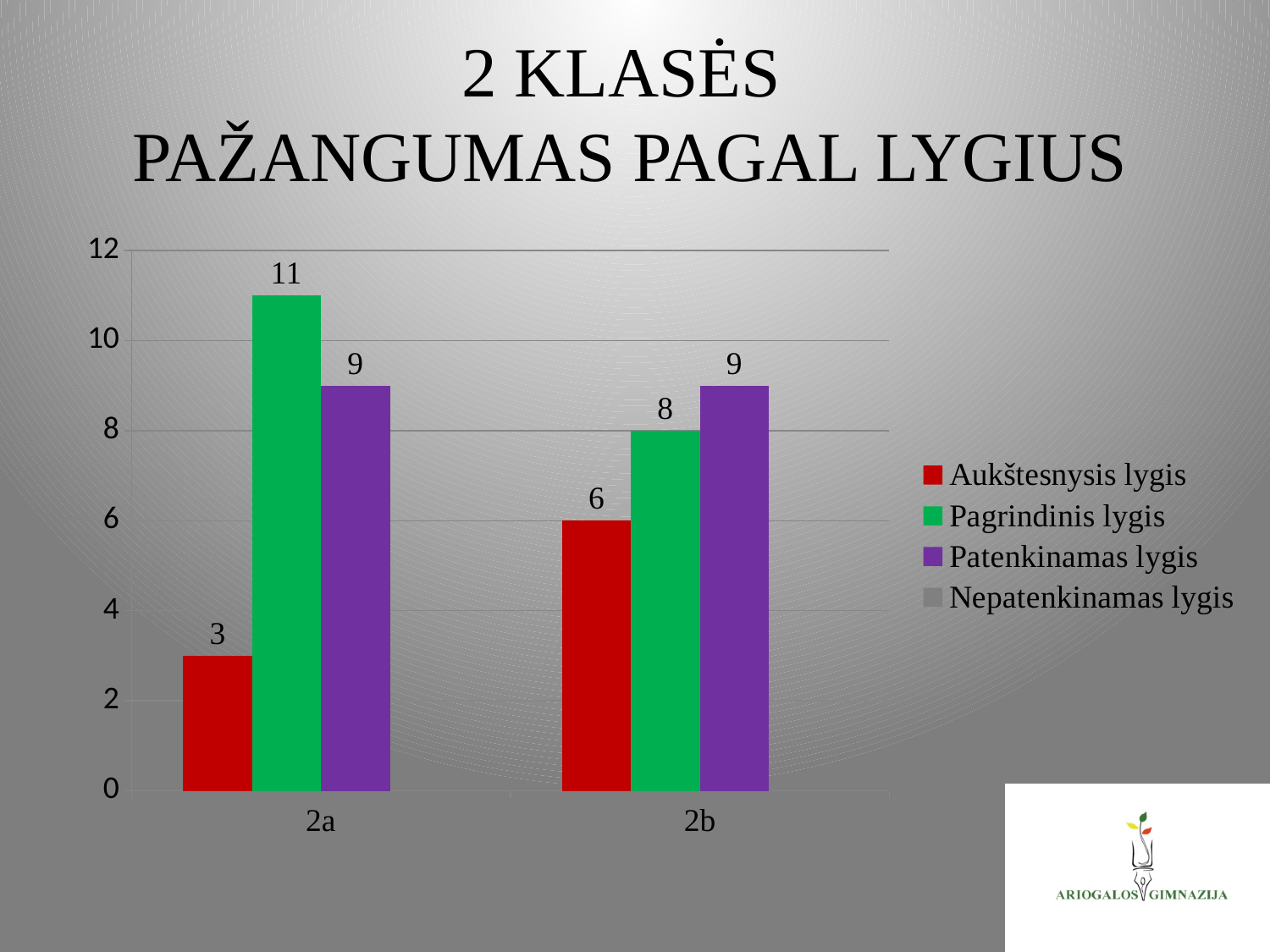
How many classes (categories) are shown on the x axis? 2 Which is larger: Aukštesnysis lygis for 2a or Aukštesnysis lygis for 2b? 2b What colour represents Patenkinamas lygis in the chart? purple What is the difference between Pagrindinis lygis for 2a and Pagrindinis lygis for 2b? 3 What is the value of Patenkinamas lygis for class 2b? 9 How many series does the legend list? 4 What kind of chart is shown on the slide? bar chart What is the value of Aukštesnysis lygis for class 2b? 6 What is the value of Aukštesnysis lygis for class 2a? 3 Which series has the highest value for class 2a? Pagrindinis lygis What is the value of Pagrindinis lygis for class 2a? 11